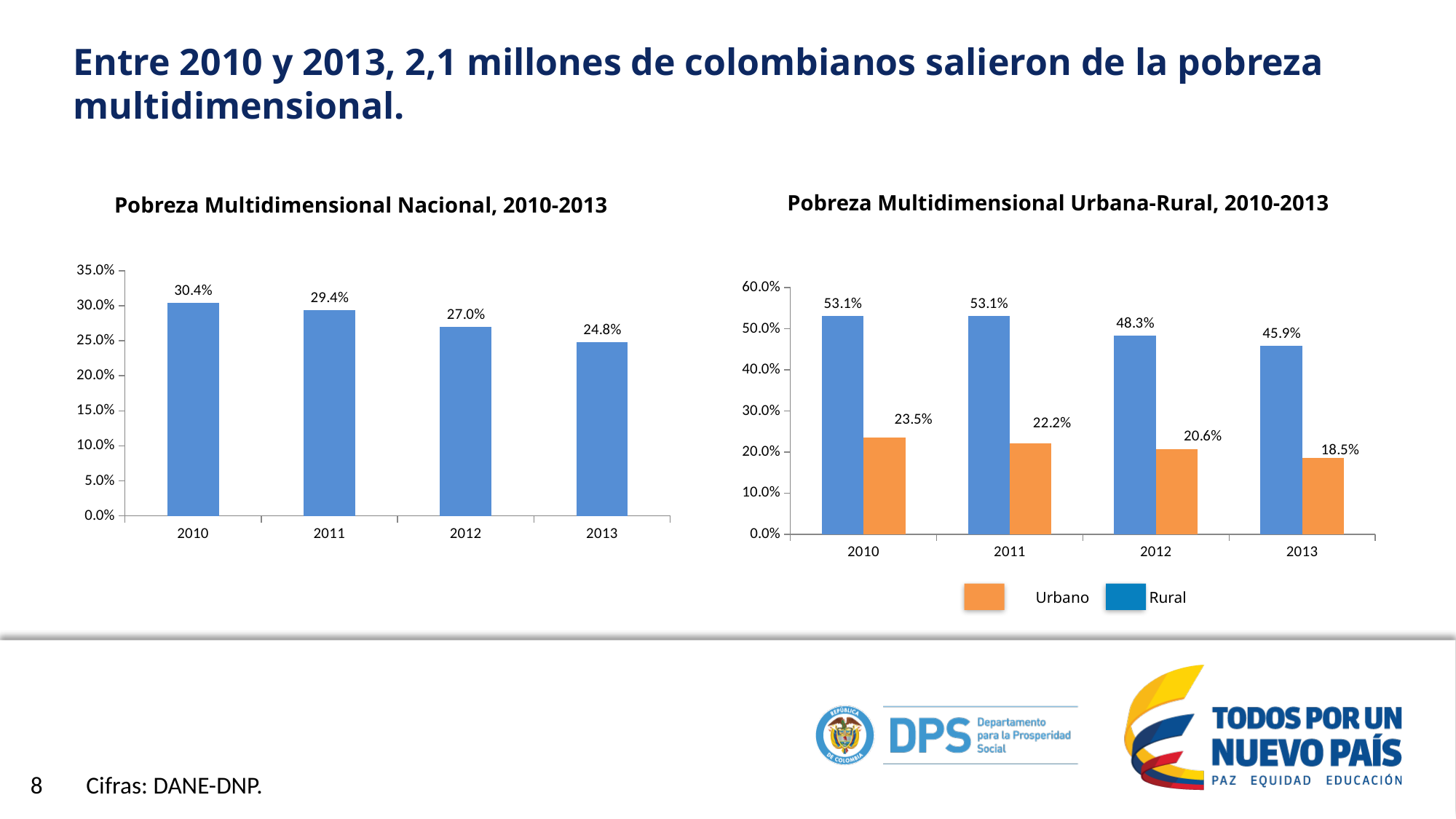
In the chart 'Pobreza Multidimensional Nacional, 2010-2013', what is the value for 2013? 24.8% In the chart 'Pobreza Multidimensional Nacional, 2010-2013', how many years are shown? 4 In the chart 'Pobreza Multidimensional Urbana-Rural, 2010-2013', which is larger in 2011: the Urbano value or the Rural value? Rural What kind of chart is 'Pobreza Multidimensional Urbana-Rural, 2010-2013'? bar chart In the chart 'Pobreza Multidimensional Urbana-Rural, 2010-2013', what is the Urbano value for 2013? 18.5% In the chart 'Pobreza Multidimensional Urbana-Rural, 2010-2013', what is the Rural value for 2012? 48.3% In the chart 'Pobreza Multidimensional Nacional, 2010-2013', what is the difference between the 2010 and 2013 values? 5.6 percentage points In the chart 'Pobreza Multidimensional Urbana-Rural, 2010-2013', what is the difference between the Rural and Urbano values in 2010? 29.6 percentage points In the chart 'Pobreza Multidimensional Nacional, 2010-2013', which year has the lowest value? 2013 In the chart 'Pobreza Multidimensional Nacional, 2010-2013', what is the value for 2010? 30.4% In the chart 'Pobreza Multidimensional Nacional, 2010-2013', do the values rise or fall from 2010 to 2013? fall In the chart 'Pobreza Multidimensional Urbana-Rural, 2010-2013', how many series does the legend list? 2